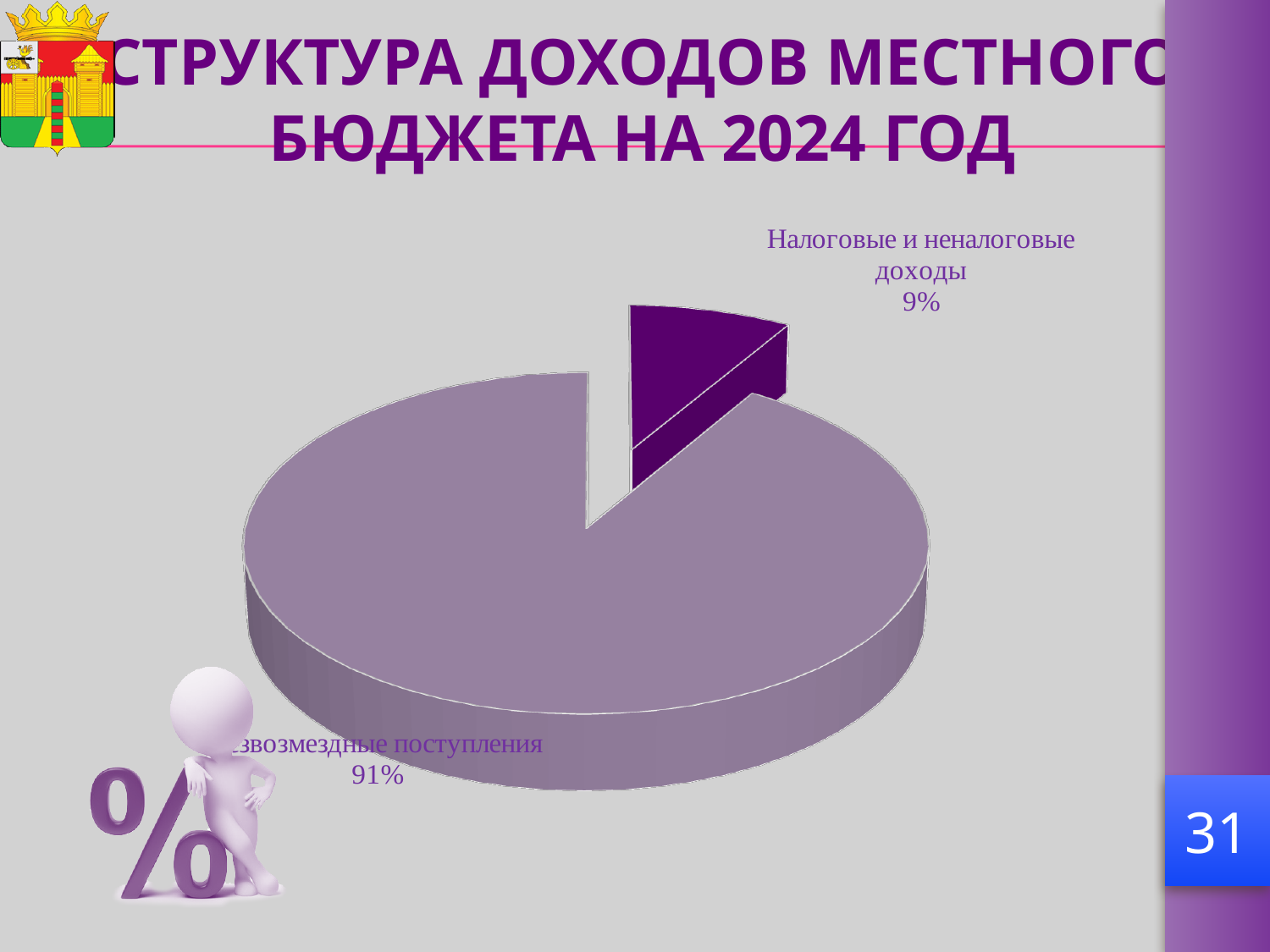
Which slice of the pie is the largest? Безвозмездные поступления What share of the pie does "Безвозмездные поступления" represent? 91% Which slice of the pie is pulled out (exploded) from the rest of the pie? Налоговые и неналоговые доходы Which slice of the pie is the smallest? Налоговые и неналоговые доходы What is the title of the slide containing the pie chart? СТРУКТУРА ДОХОДОВ МЕСТНОГО БЮДЖЕТА НА 2024 ГОД What kind of chart is shown on the slide? Pie chart Which is larger: "Налоговые и неналоговые доходы" or "Безвозмездные поступления"? Безвозмездные поступления How many slices does the pie chart have? 2 What is the difference in percentage points between "Безвозмездные поступления" and "Налоговые и неналоговые доходы"? 82 Is the share for "Налоговые и неналоговые доходы" greater or less than 10%? less What share of the pie does "Налоговые и неналоговые доходы" represent? 9%